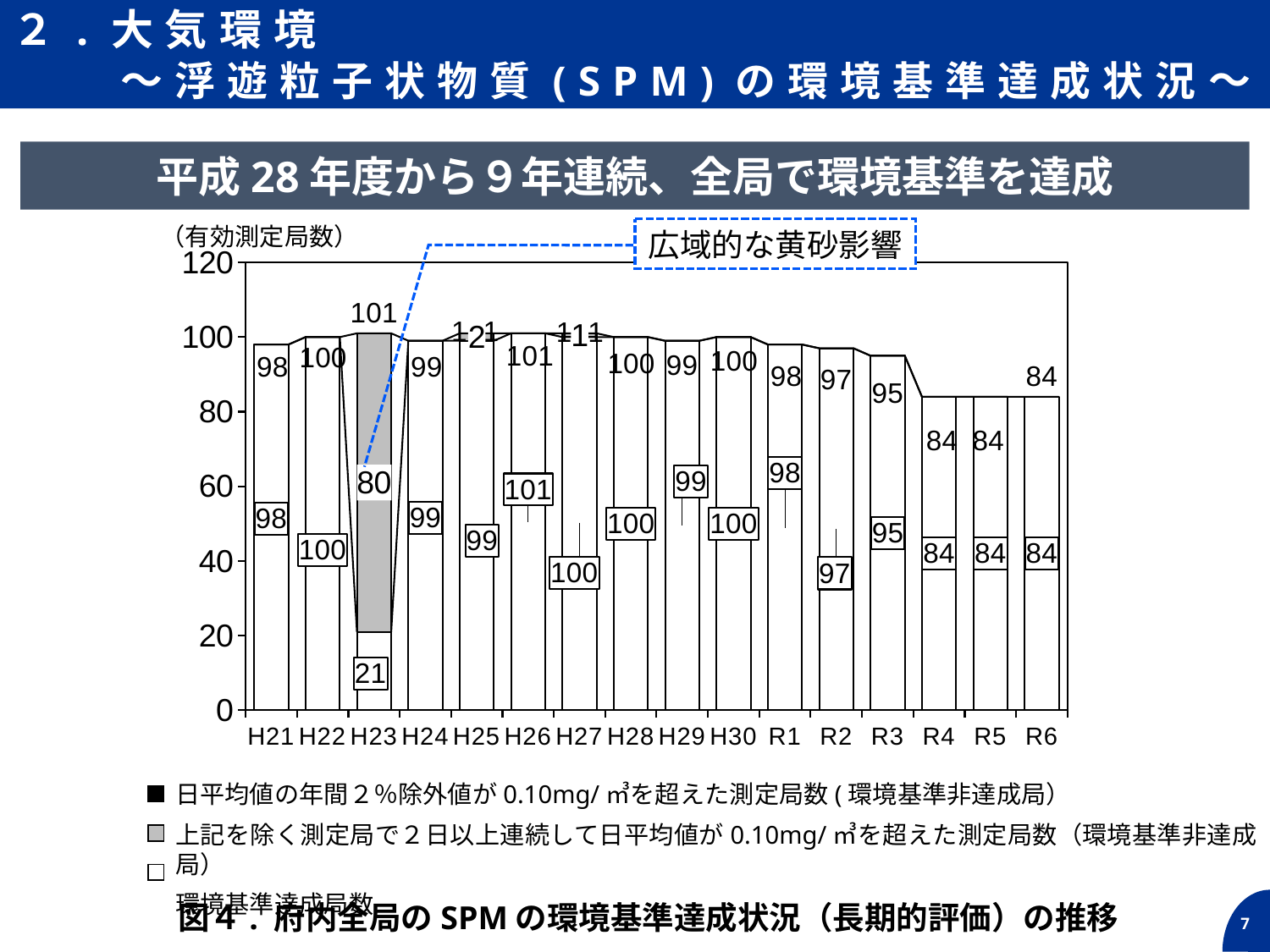
What is the value for H21? 98 What is the total number of stations shown for H23? 101 What is the value of the grey segment (stations exceeding 0.10mg/m³ for 2+ consecutive days) in H23? 80 What is the value of the white segment (環境基準達成局数) in H23? 21 Which is larger, the value for H21 or the value for R3? H21 How many series does the legend list? 3 What is the value for R6? 84 Do the values rise or fall from H30 to R6? Fall What is the difference between the values for H22 and R6? 16 Which year does the annotation '広域的な黄砂影響' point to? H23 What kind of chart is this? Stacked bar chart How many fiscal years are shown on the x axis? 16